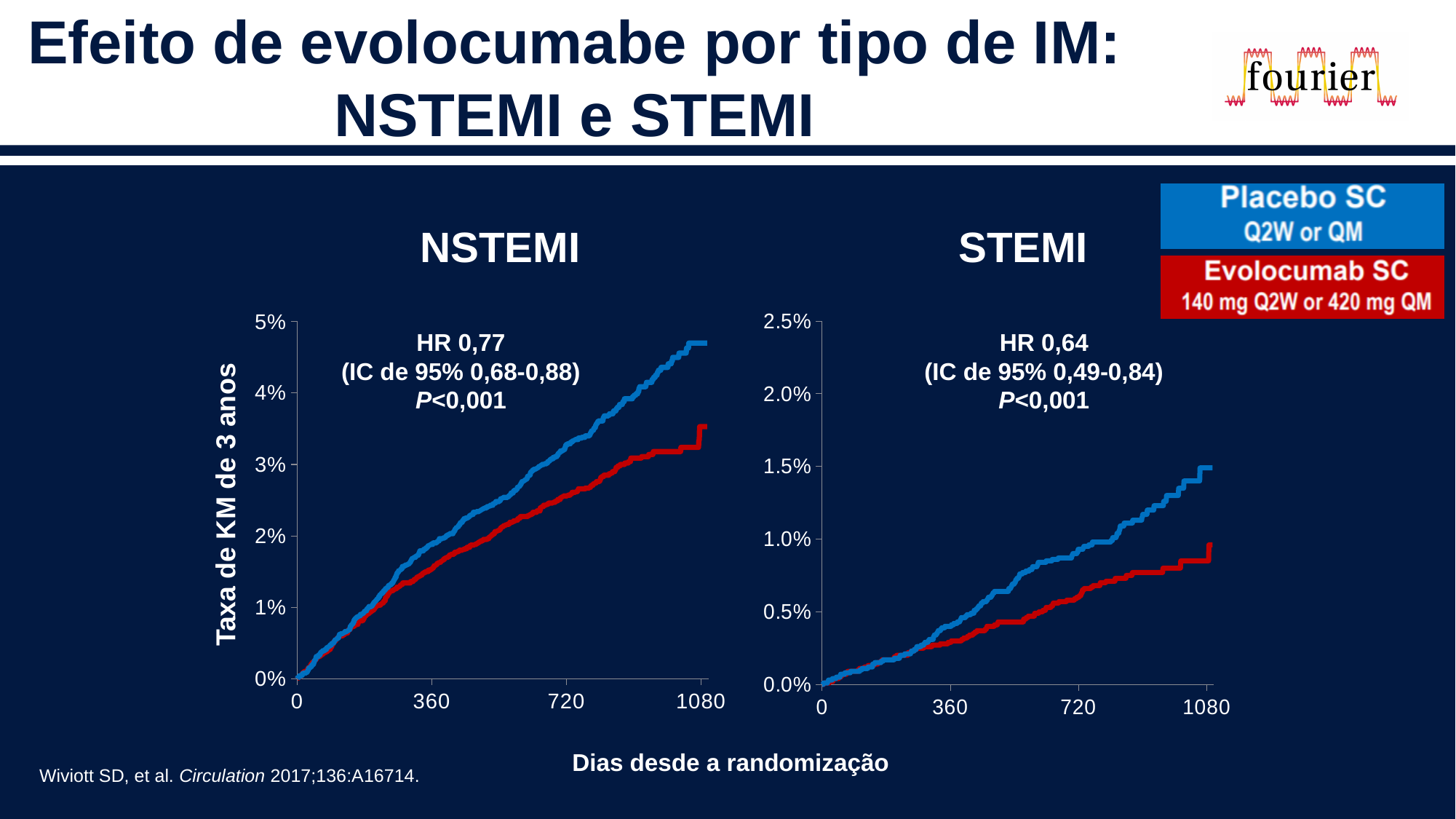
In the STEMI chart, which series has the higher value at day 1080, Placebo SC or Evolocumab SC? Placebo SC In the STEMI chart, do the Placebo SC values rise or fall as days since randomization increase? rise In the NSTEMI chart, is the Evolocumab SC value at day 1080 greater or less than 3%? greater How many series does the legend list for the charts? 2 In the NSTEMI chart, is the Placebo SC value at day 1080 greater or less than 4%? greater What hazard ratio is shown on the STEMI chart? HR 0,64 Which colour represents Evolocumab SC in the legend? red In the STEMI chart, is the Placebo SC value at day 1080 greater or less than 1.0%? greater In the NSTEMI chart, do the Evolocumab SC values rise or fall along the x axis? rise In the NSTEMI chart, which series has the higher value at day 1080, Placebo SC or Evolocumab SC? Placebo SC What kind of chart is the NSTEMI chart? line chart